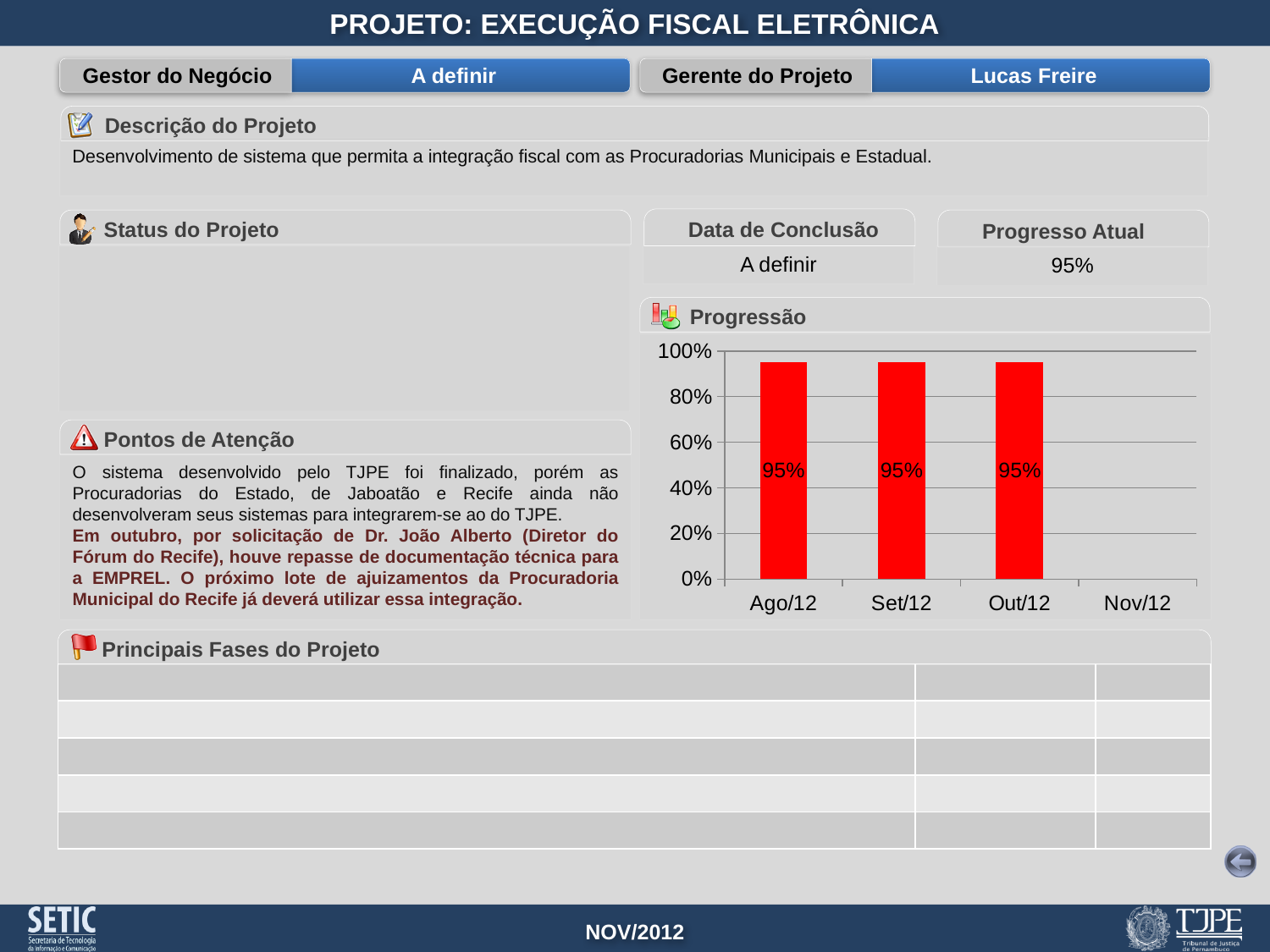
Is the value for Ago/12 in the Progressão chart greater or less than 100%? less How many categories are shown on the x axis of the Progressão chart? 4 What is the value for Ago/12 in the Progressão chart? 95% Do the values in the Progressão chart rise, fall or stay flat from Ago/12 to Out/12? stay flat What is the difference between the values for Ago/12 and Out/12 in the Progressão chart? 0% Which category in the Progressão chart has no bar plotted? Nov/12 What is the value for Set/12 in the Progressão chart? 95% What kind of chart is shown under "Progressão"? bar chart What colour are the bars in the Progressão chart? red How many bars are plotted in the Progressão chart? 3 Is the value for Out/12 in the Progressão chart greater or less than 80%? greater What is the value for Out/12 in the Progressão chart? 95%